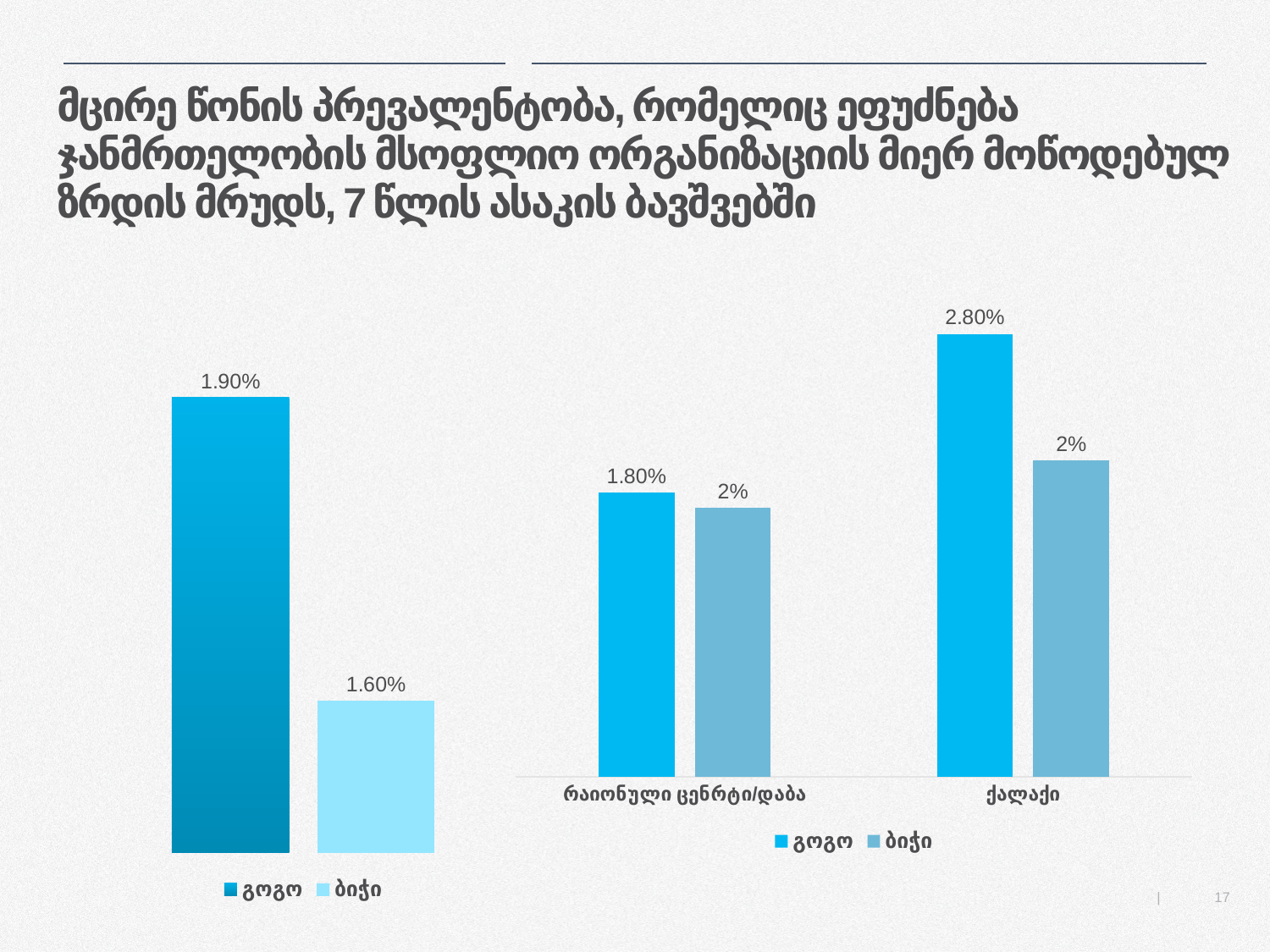
What type of chart is the right chart? Bar chart On the right chart, what is the value for ბიჭი in ქალაქი? 2% On the right chart, what is the value for გოგო in ქალაქი? 2.80% On the right chart, what is the value for გოგო in რაიონული ცენტრი/დაბა? 1.80% On the left chart, what is the difference between the გოგო and ბიჭი values? 0.30% On the right chart, how many categories are shown on the x axis? 2 On the right chart, what is the difference between the გოგო values for ქალაქი and რაიონული ცენტრი/დაბა? 1.00% On the left chart, which series has the higher value, გოგო or ბიჭი? გოგო On the left chart, what is the value for გოგო? 1.90% On the left chart, what is the value for ბიჭი? 1.60% How many series does the legend of the right chart list? 2 On the right chart, which category has the highest გოგო value? ქალაქი